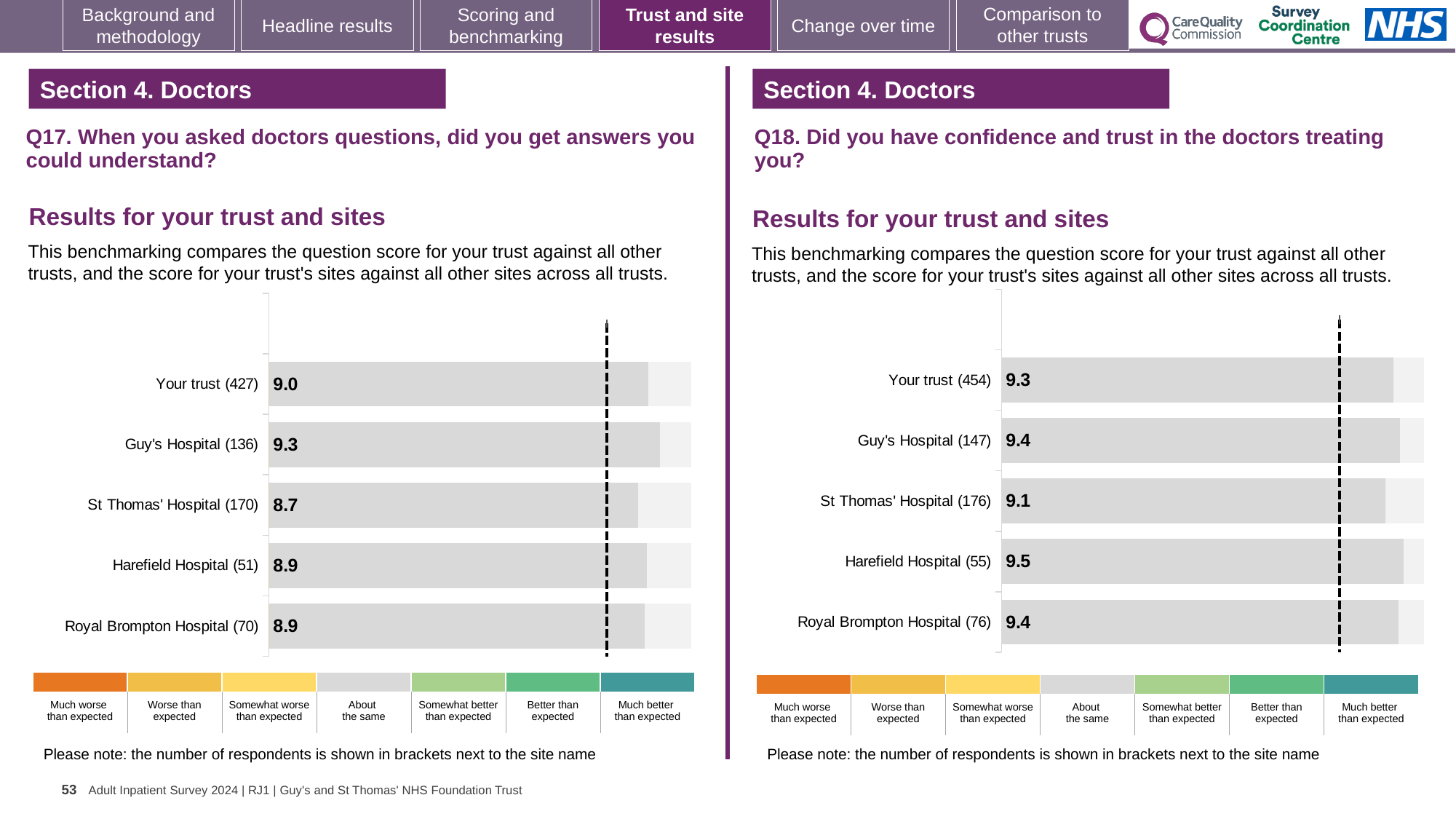
In the Q18 chart on the right, what is the score for Harefield Hospital? 9.5 What kind of chart is used for the Q18 results on the right? Bar chart In the Q18 chart on the right, which site has the lowest score? St Thomas' Hospital In the Q17 chart on the left, what is the score for St Thomas' Hospital? 8.7 In the Q17 chart on the left, which site has the lowest score? St Thomas' Hospital In the Q18 chart on the right, which has the higher score, Harefield Hospital or St Thomas' Hospital? Harefield Hospital In the Q18 chart on the right, what is the score for Your trust? 9.3 In the Q17 chart on the left, what is the score for Guy's Hospital? 9.3 How many bars are shown in the Q17 chart on the left? 5 In the Q17 chart on the left, what is the difference between the scores for Guy's Hospital and St Thomas' Hospital? 0.6 In the Q17 chart on the left, which site has the highest score? Guy's Hospital In the Q18 chart on the right, which site has the highest score? Harefield Hospital